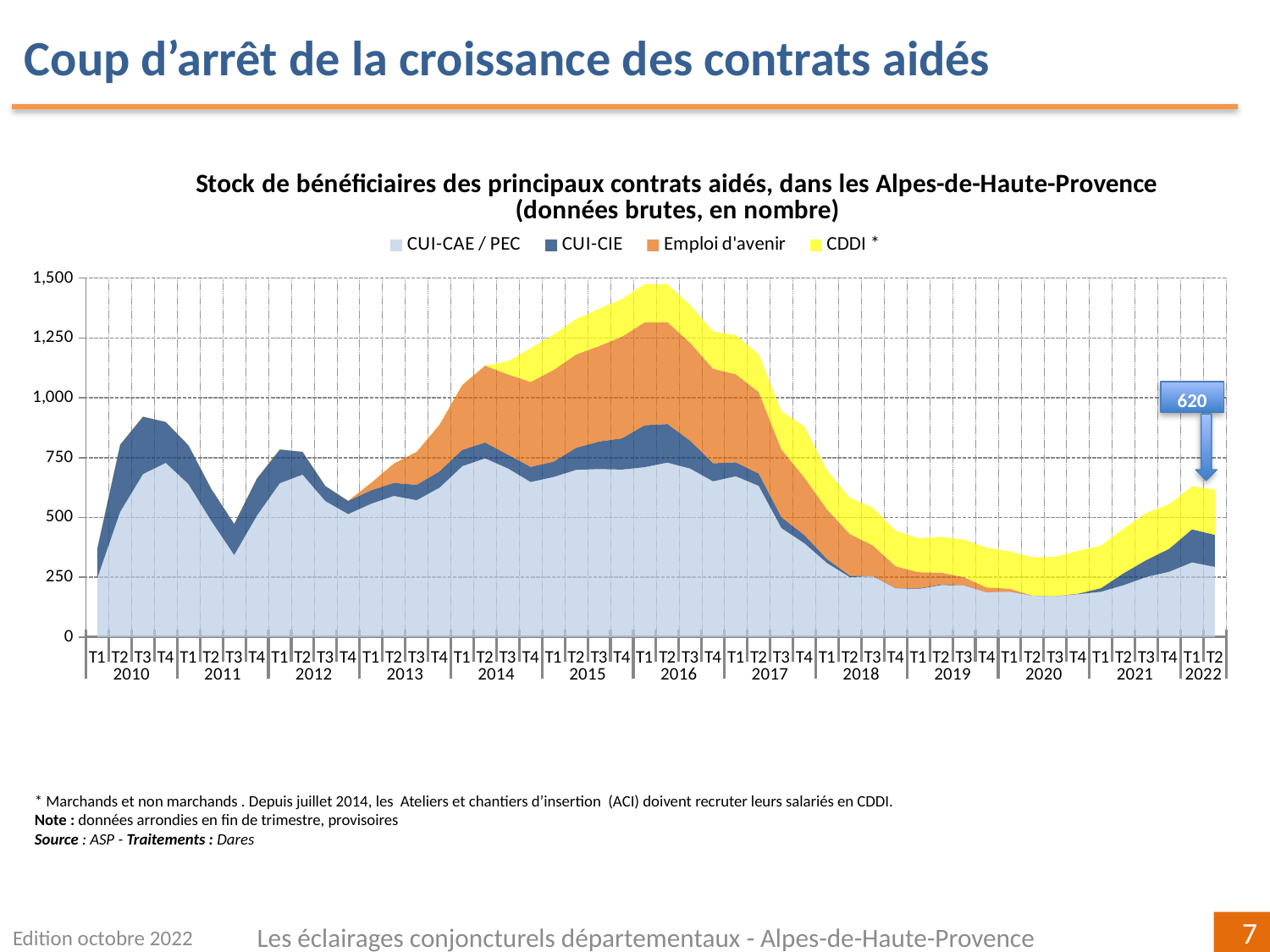
Which is larger, the total stock in T1 2016 or in T1 2020? T1 2016 What is the first series listed in the legend? CUI-CAE / PEC Is the total stock in T1 2016 greater or less than 1,250? greater What kind of chart is shown on the slide? stacked area chart Is the total stock in T3 2020 greater or less than 500? less Is the total stock in T1 2010 greater or less than 500? less How many years are shown on the x axis? 13 How many series does the legend list? 4 Does the total stock rise or fall between 2016 and 2020? fall Which series is shown in yellow? CDDI * What total value is labelled for T2 2022? 620